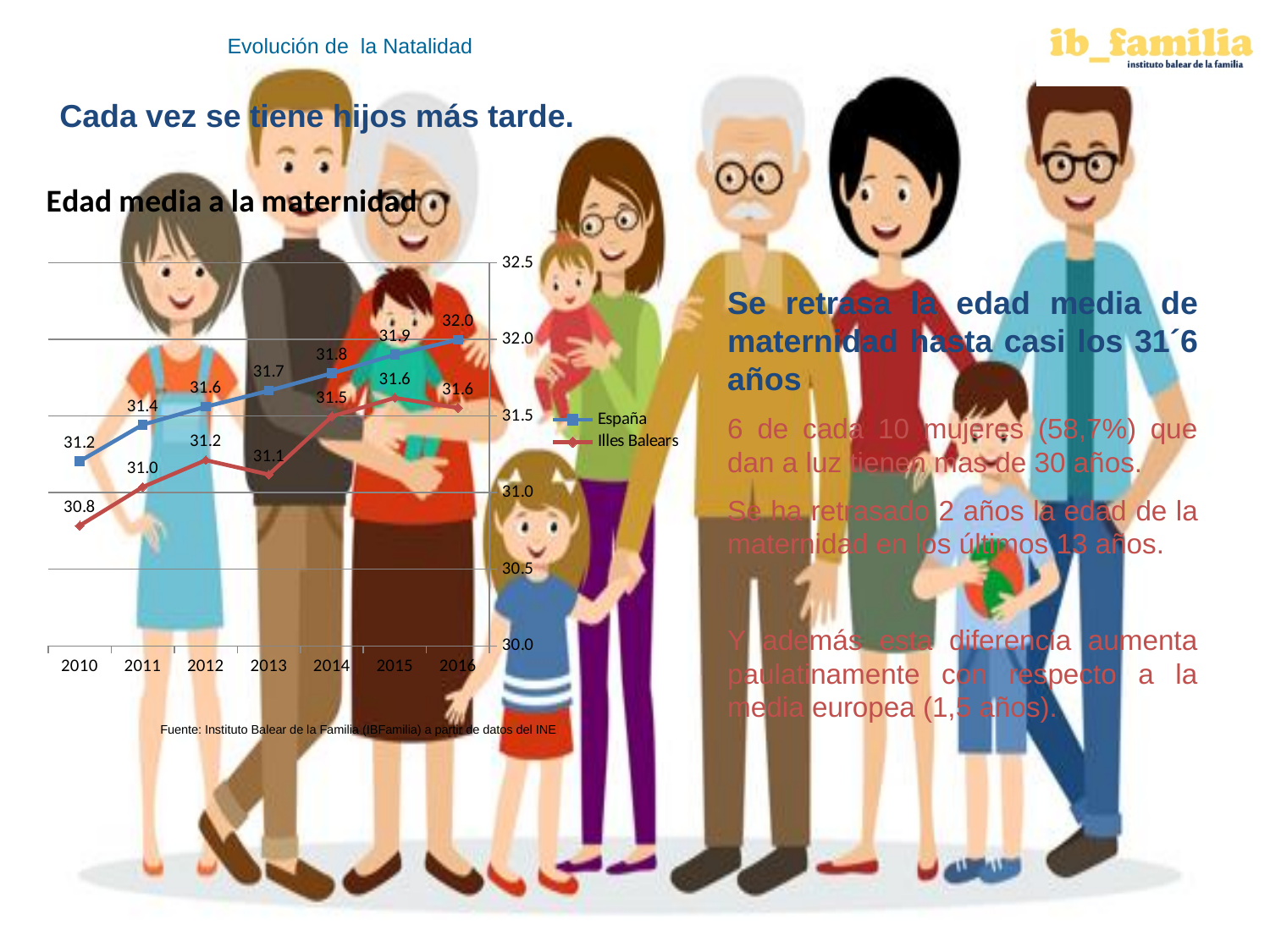
What type of chart is shown on the slide? line chart In which year is the Illes Balears series lowest? 2010 Does the España series rise or fall from 2010 to 2016? rise How many years are shown on the x axis of the chart? 7 What is the difference between España and Illes Balears in 2014? 0.3 How many series does the chart legend list? 2 What is the title of the chart? Edad media a la maternidad In which year is the España series highest? 2016 What is the value for Illes Balears in 2013? 31.1 What is the value for Illes Balears in 2010? 30.8 What is the value for España in 2016? 32.0 Which series has the larger value in 2012, España or Illes Balears? España